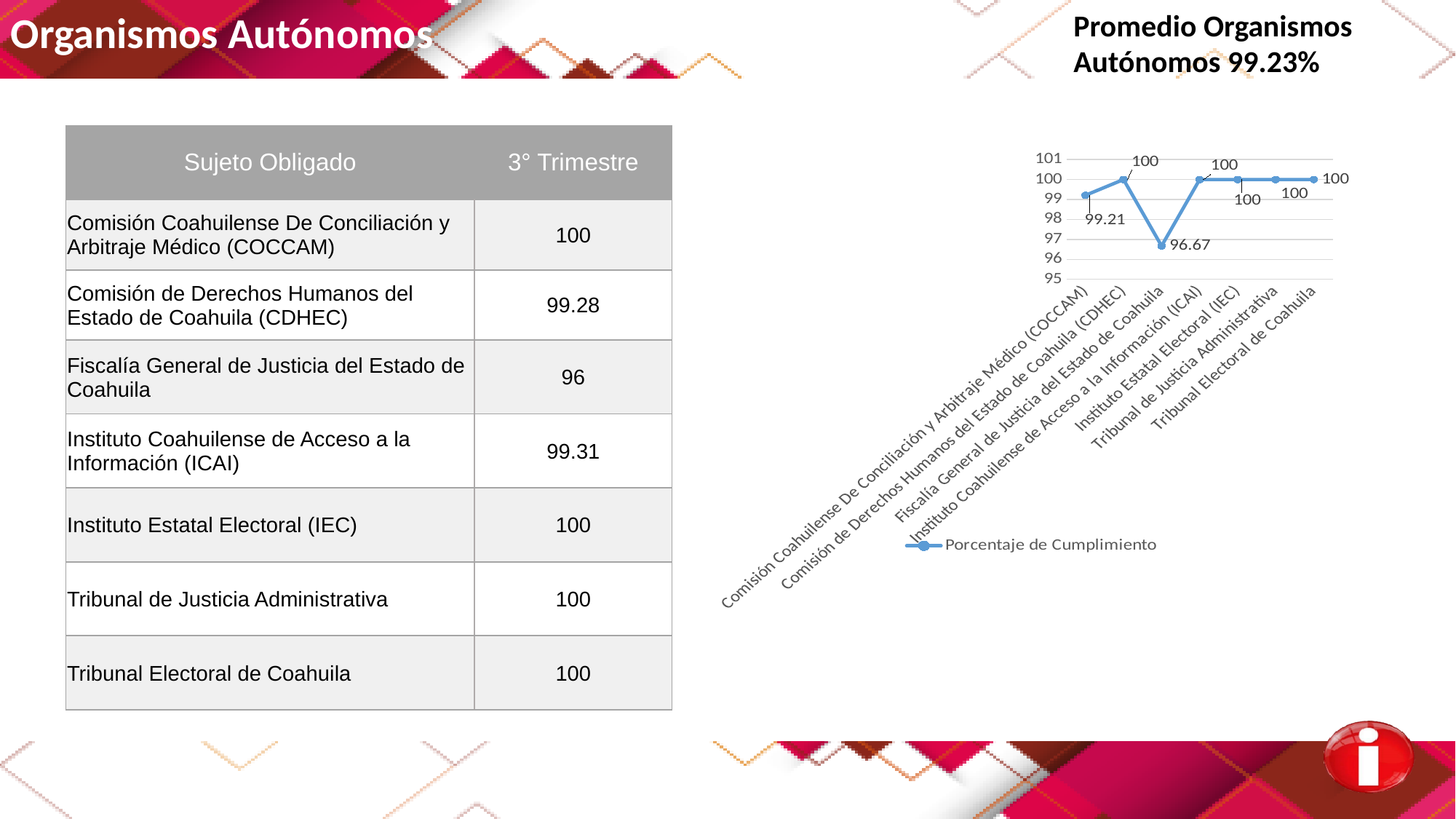
What is the value plotted for Fiscalía General de Justicia del Estado de Coahuila in the chart? 96.67 What is the value plotted for Tribunal Electoral de Coahuila in the chart? 100 Is the value for Fiscalía General de Justicia del Estado de Coahuila greater or less than 97? less What is the value plotted for Comisión Coahuilense De Conciliación y Arbitraje Médico (COCCAM) in the chart? 99.21 What is the name of the series shown in the chart legend? Porcentaje de Cumplimiento What is the difference between the value for Instituto Estatal Electoral (IEC) and the value for Fiscalía General de Justicia del Estado de Coahuila in the chart? 3.33 How many categories are plotted on the x axis of the chart? 7 What kind of chart is shown on the slide? line chart In the chart, which is larger: the value for COCCAM or the value for Fiscalía General de Justicia del Estado de Coahuila? COCCAM Which category has the lowest value in the chart? Fiscalía General de Justicia del Estado de Coahuila How many series does the chart legend list? 1 What is the difference between the value for Comisión Coahuilense De Conciliación y Arbitraje Médico (COCCAM) and the value for Fiscalía General de Justicia del Estado de Coahuila in the chart? 2.54